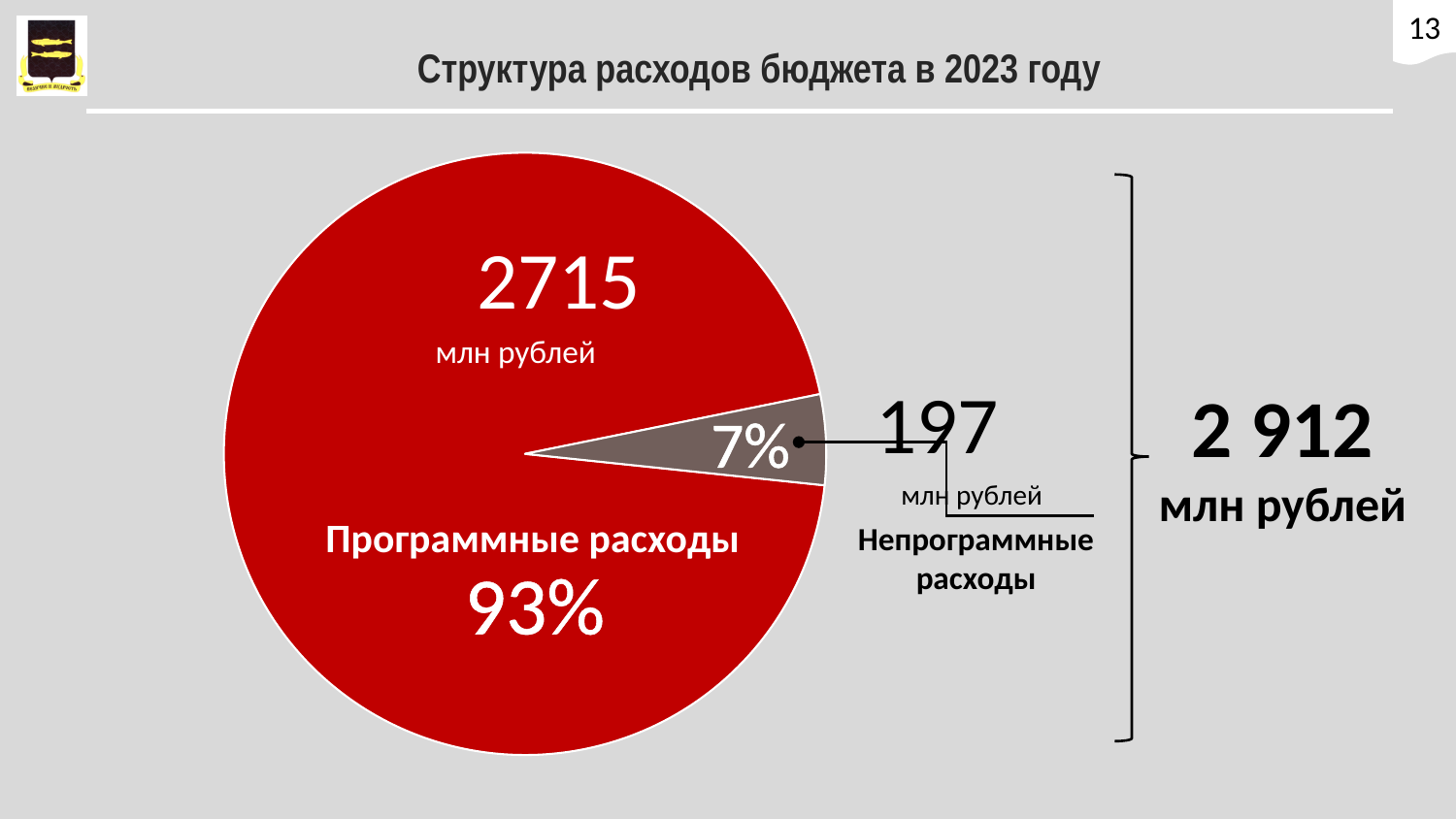
What share of the pie is Программные расходы? 93% What kind of chart is shown on the slide? Pie chart What is the difference between Программные расходы and Непрограммные расходы in млн рублей? 2518 млн рублей Which is larger, Программные расходы or Непрограммные расходы? Программные расходы What share of the pie is Непрограммные расходы? 7% Which slice is the smallest? Непрограммные расходы What is the value for Непрограммные расходы? 197 млн рублей What total is shown next to the bracket to the right of the pie chart? 2 912 млн рублей What is the title of the slide with the pie chart? Структура расходов бюджета в 2023 году What is the value for Программные расходы? 2715 млн рублей Which slice is the largest? Программные расходы How many slices does the pie chart have? 2